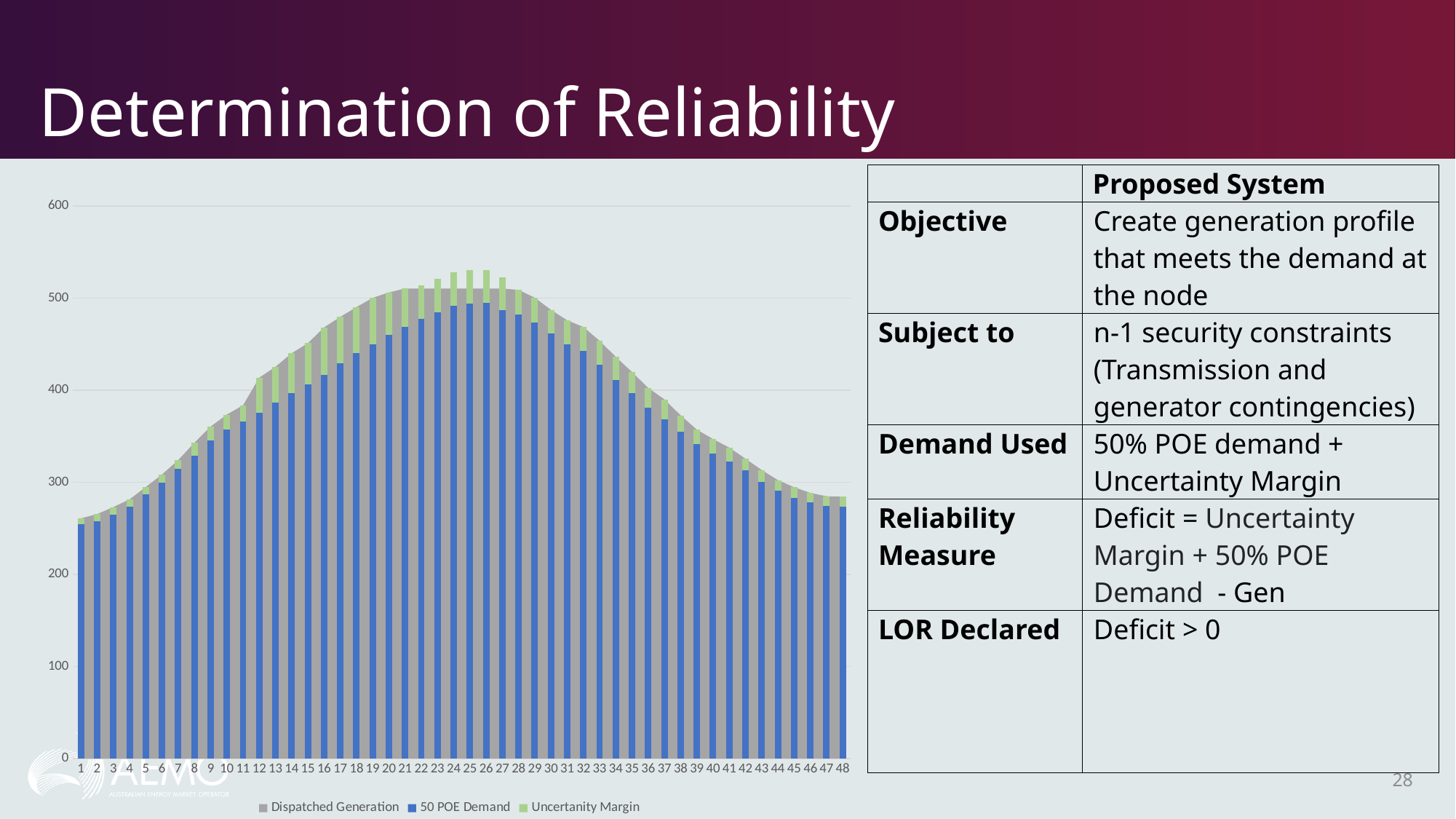
How many categories are shown along the x axis of the chart? 48 How many series does the chart legend list? 3 Is the 50 POE Demand value at category 40 greater or less than 300? greater Do the 50 POE Demand values rise or fall from category 1 to category 25? rise What kind of chart is used to plot the 50 POE Demand series? bar chart Is the 50 POE Demand value at category 25 greater or less than 400? greater Which is larger, the 50 POE Demand value at category 20 or at category 40? category 20 Do the 50 POE Demand values rise or fall from category 26 to category 48? fall What colour represents the Uncertainty Margin series in the chart? green Is the 50 POE Demand value at category 1 greater or less than 300? less